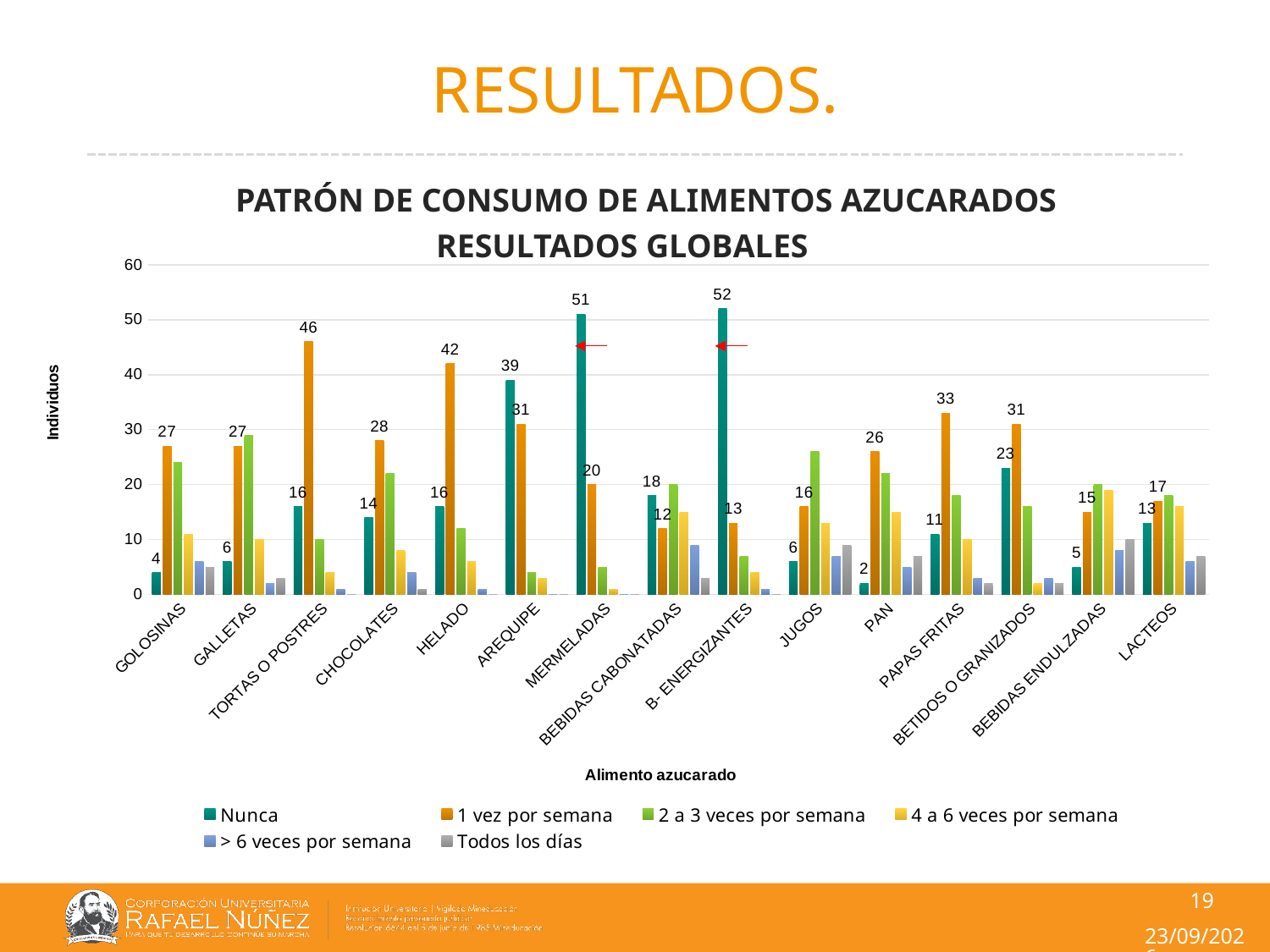
Is the '2 a 3 veces por semana' value for JUGOS greater or less than 20? greater For AREQUIPE, which is larger: the 'Nunca' value or the '1 vez por semana' value? Nunca What is the value of the 'Nunca' series for PAPAS FRITAS? 11 How many food categories are shown on the x axis? 15 What is the value of the 'Nunca' series for MERMELADAS? 51 What kind of chart is shown on the slide? bar chart How many series does the legend list? 6 Which food has the highest value in the '1 vez por semana' series? TORTAS O POSTRES Which food has the lowest value in the 'Nunca' series? PAN For HELADO, what is the difference between the '1 vez por semana' value and the 'Nunca' value? 26 What is the value of the '1 vez por semana' series for TORTAS O POSTRES? 46 Which food has the highest value in the 'Nunca' series? B- ENERGIZANTES